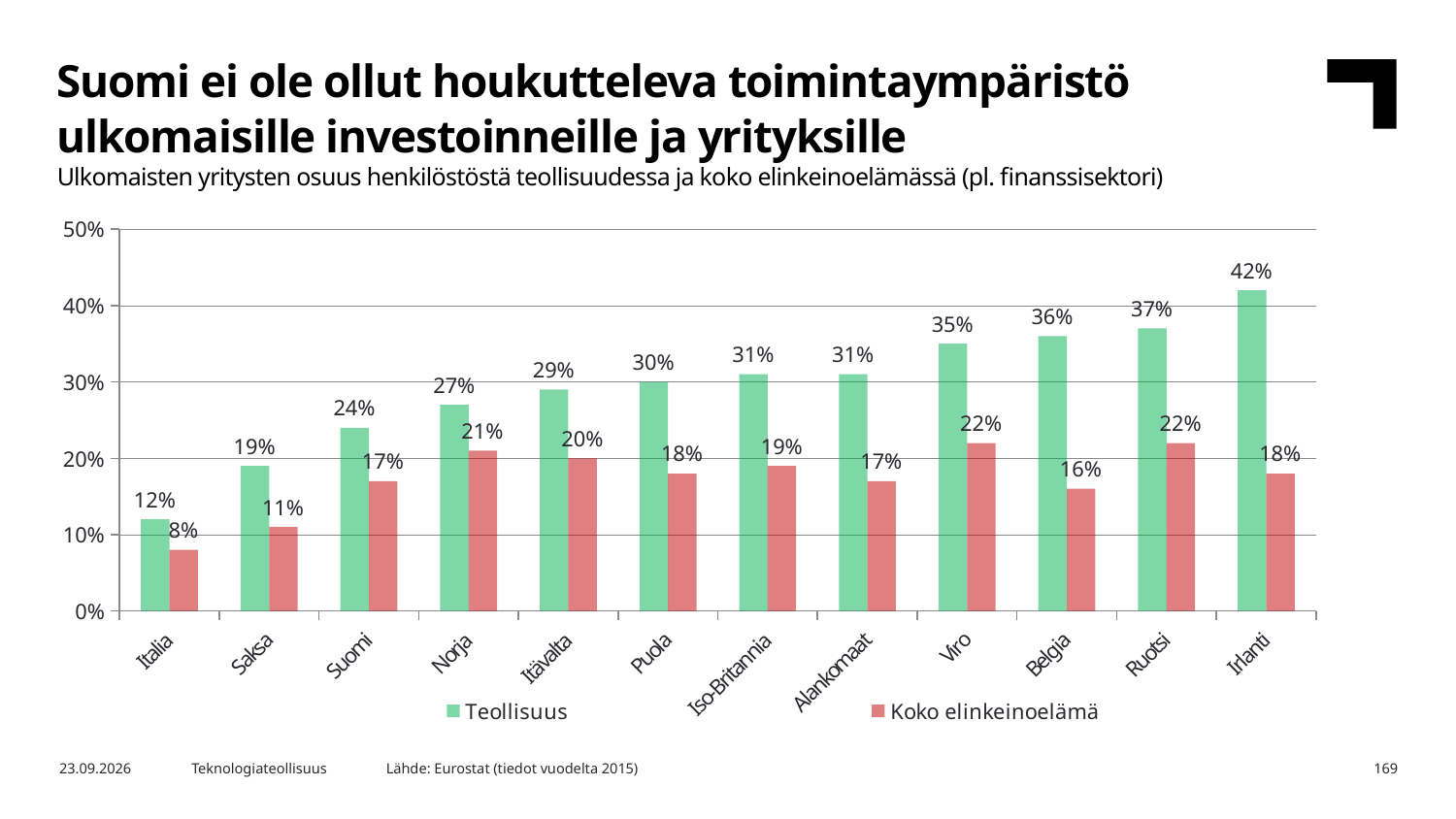
Which colour represents the Koko elinkeinoelämä series? Red How many countries are shown on the x axis? 12 Which country has the lowest Koko elinkeinoelämä value? Italia What kind of chart is shown on the slide? Bar chart Which country has the highest Teollisuus value? Irlanti Which is larger: the Teollisuus value for Viro or the Teollisuus value for Ruotsi? Ruotsi Is the Teollisuus value for Irlanti greater or less than 40%? greater Do the Teollisuus values generally rise or fall from Italia to Irlanti? Rise What is the Koko elinkeinoelämä value for Norja? 21% How many series does the legend list? 2 What is the difference between the Teollisuus and Koko elinkeinoelämä values for Belgia? 20 percentage points What is the Teollisuus value for Suomi? 24%